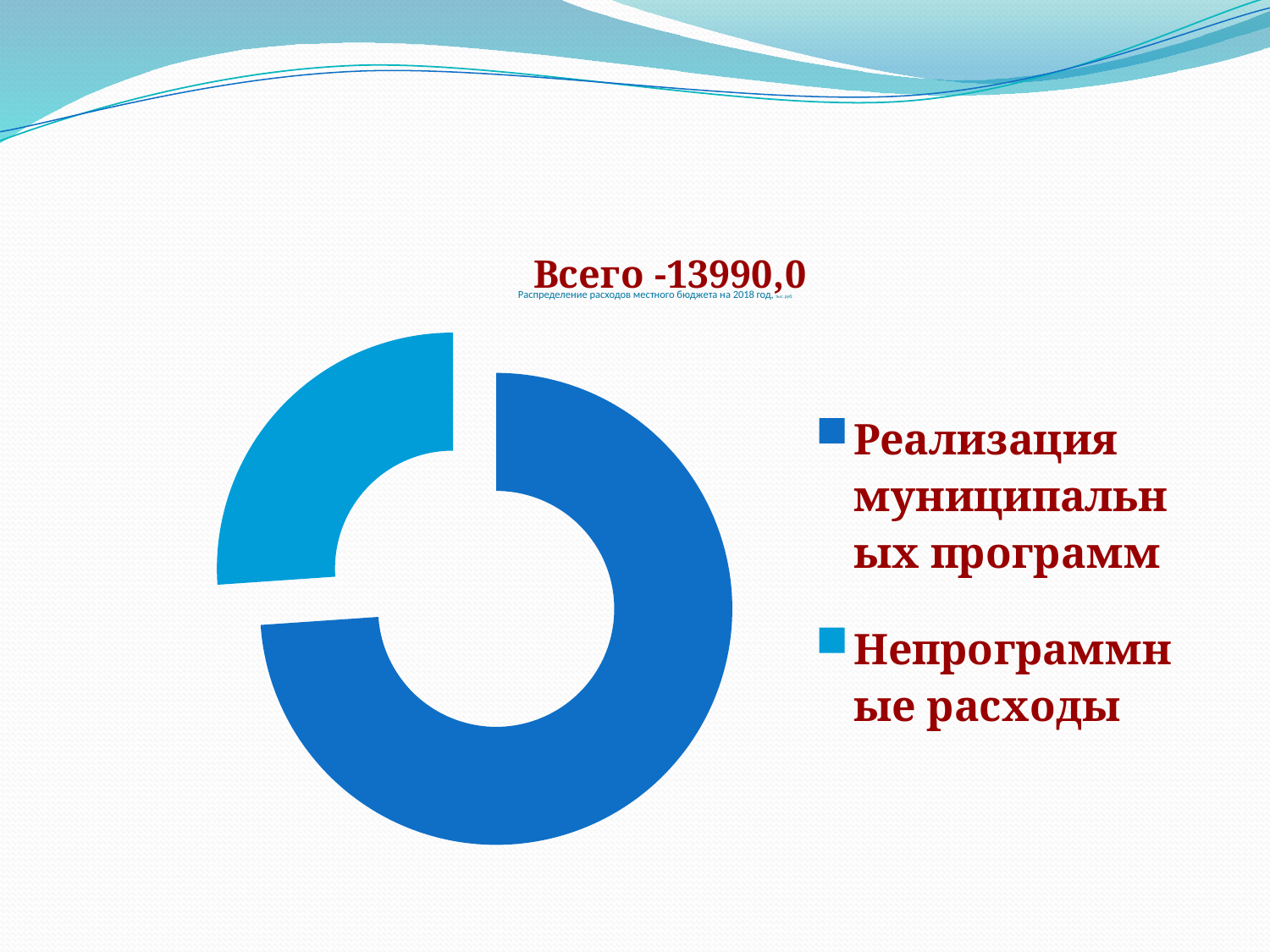
Which colour represents Непрограммные расходы in the chart? Light blue Is the share for Реализация муниципальных программ greater or less than half of the chart? greater Is the share for Непрограммные расходы greater or less than half of the chart? less What total value is stated above the chart? Всего -13990,0 What kind of chart is shown on the slide? Doughnut (pie) chart Which category has the largest share of the chart? Реализация муниципальных программ Which category has the smallest share of the chart? Непрограммные расходы Which is larger: the share for Реализация муниципальных программ or the share for Непрограммные расходы? Реализация муниципальных программ How many categories does the legend of the chart list? 2